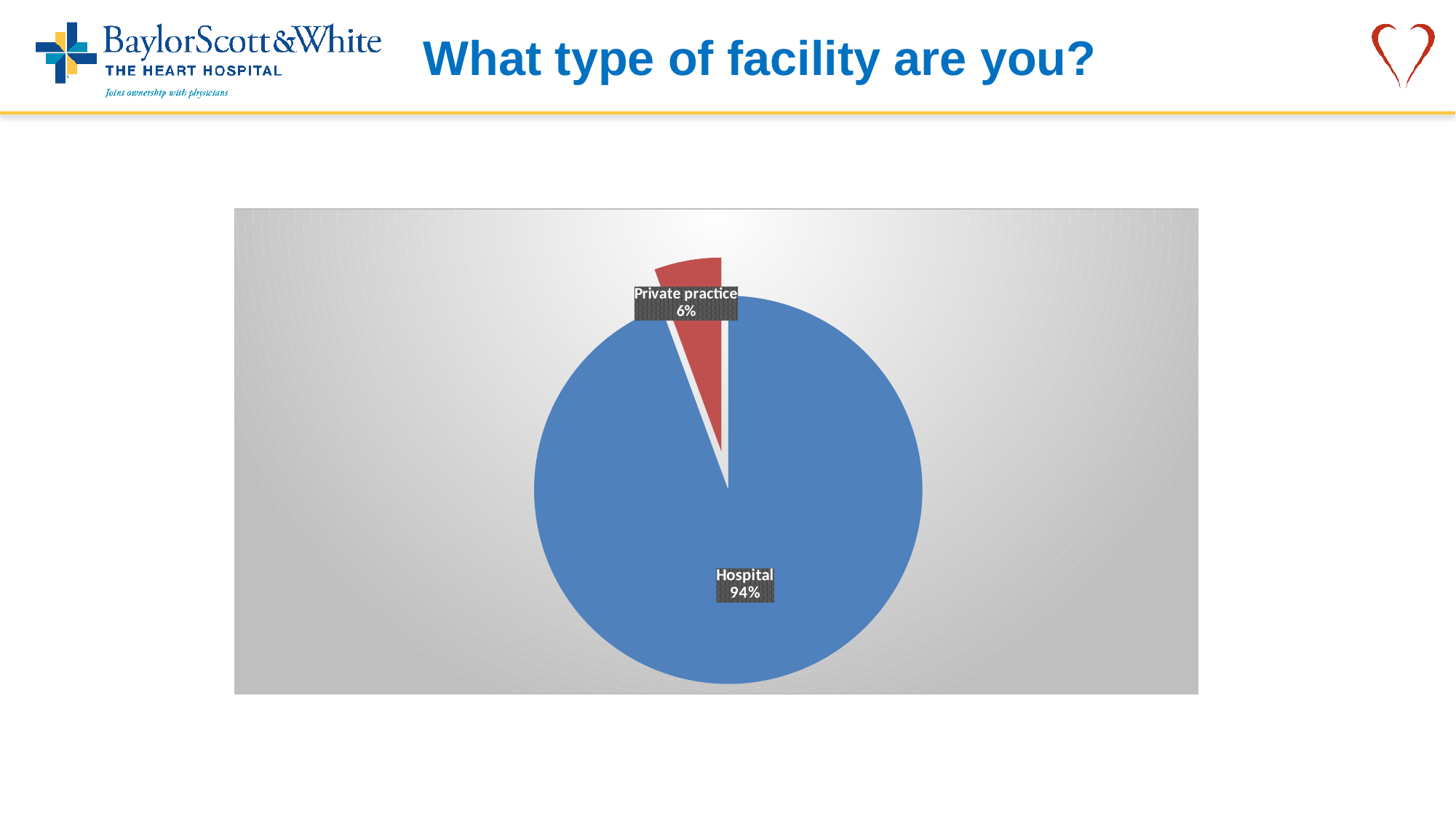
Which category has the largest slice of the pie? Hospital What is the difference in percentage points between the Hospital and Private practice slices? 88 What share of the pie is labelled Private practice? 6% How many slices does the pie chart have? 2 Which category has the smallest slice of the pie? Private practice Which is larger, the Hospital slice or the Private practice slice? Hospital What is the title of the slide containing the chart? What type of facility are you? What kind of chart is shown on the slide? Pie chart What colour is the Private practice slice? Red What share of the pie is labelled Hospital? 94%